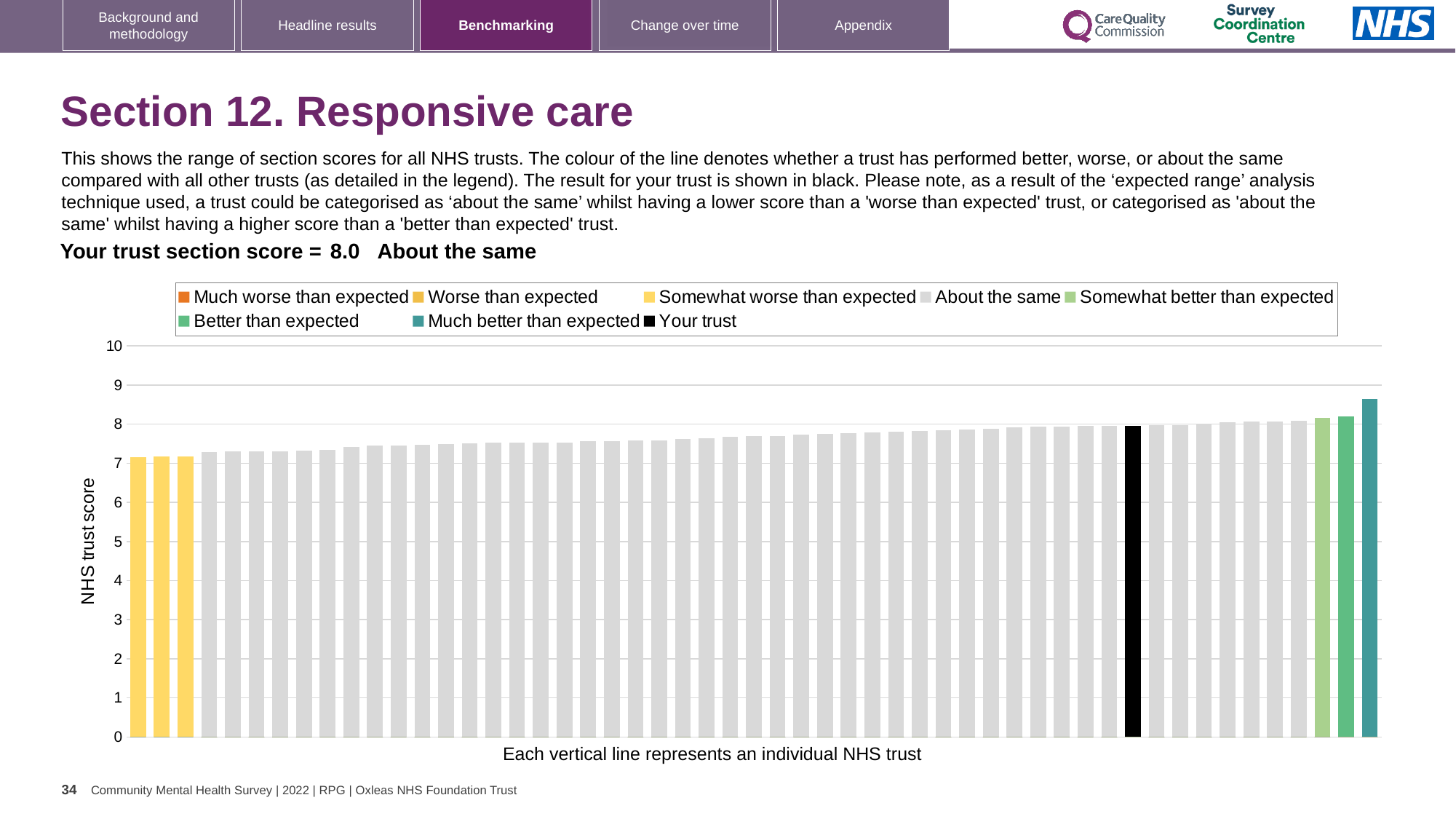
Which is larger: the score for your trust (black bar) or the rightmost bar? the rightmost bar How many entries does the chart legend list? 8 Which legend category does the tallest bar belong to? Much better than expected Is the value of the tallest bar greater or less than 9? less Is the value of the shortest bar greater or less than 7? greater Which category does your trust fall into according to the slide? About the same What is the section score for your trust shown on the slide? 8.0 Is the value of the tallest bar greater or less than 8? greater What is the label on the vertical axis of the chart? NHS trust score Do the bar values rise or fall from left to right along the x axis? rise How many bars are coloured as 'Somewhat worse than expected'? 3 What kind of chart is shown on the slide? bar chart